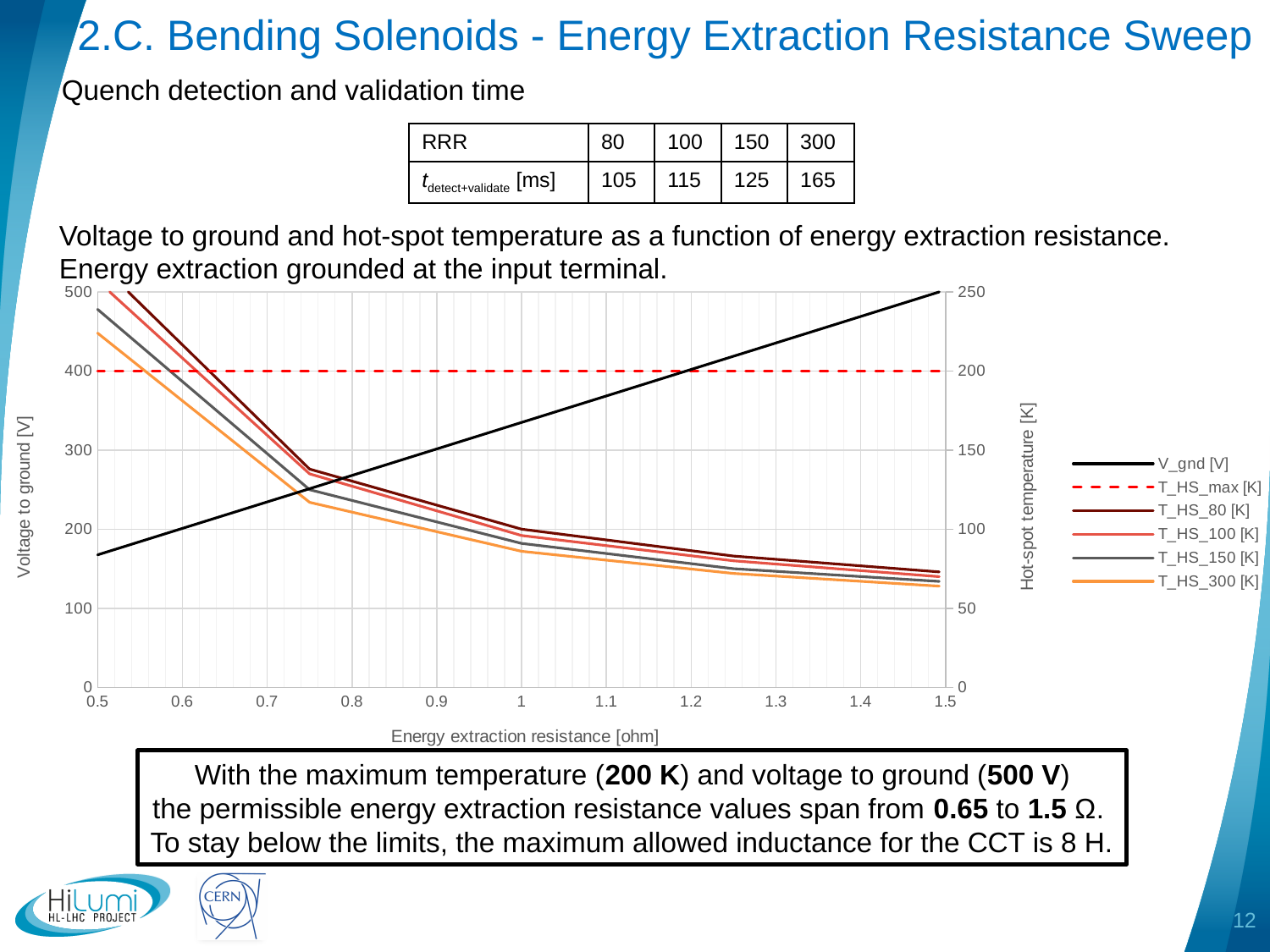
What is the label of the chart's x axis? Energy extraction resistance [ohm] At what constant hot-spot temperature is the dashed T_HS_max [K] line drawn? 200 Is the value of V_gnd [V] at 0.5 ohm greater or less than 200? less Is the value of V_gnd [V] at 1.4 ohm greater or less than 400? greater How many series does the chart legend list? 6 Is the value of T_HS_300 [K] at 1.5 ohm greater or less than 100? less Which of the RRR-dependent hot-spot temperature series is the highest across the resistance range? T_HS_80 [K] Does the T_HS_80 [K] series rise or fall as energy extraction resistance increases? fall Does the V_gnd [V] series rise or fall as energy extraction resistance increases? rise What type of chart is shown on the slide? line chart Which of the RRR-dependent hot-spot temperature series is the lowest across the resistance range? T_HS_300 [K] At 1.0 ohm, which series has the higher hot-spot temperature, T_HS_80 [K] or T_HS_300 [K]? T_HS_80 [K]